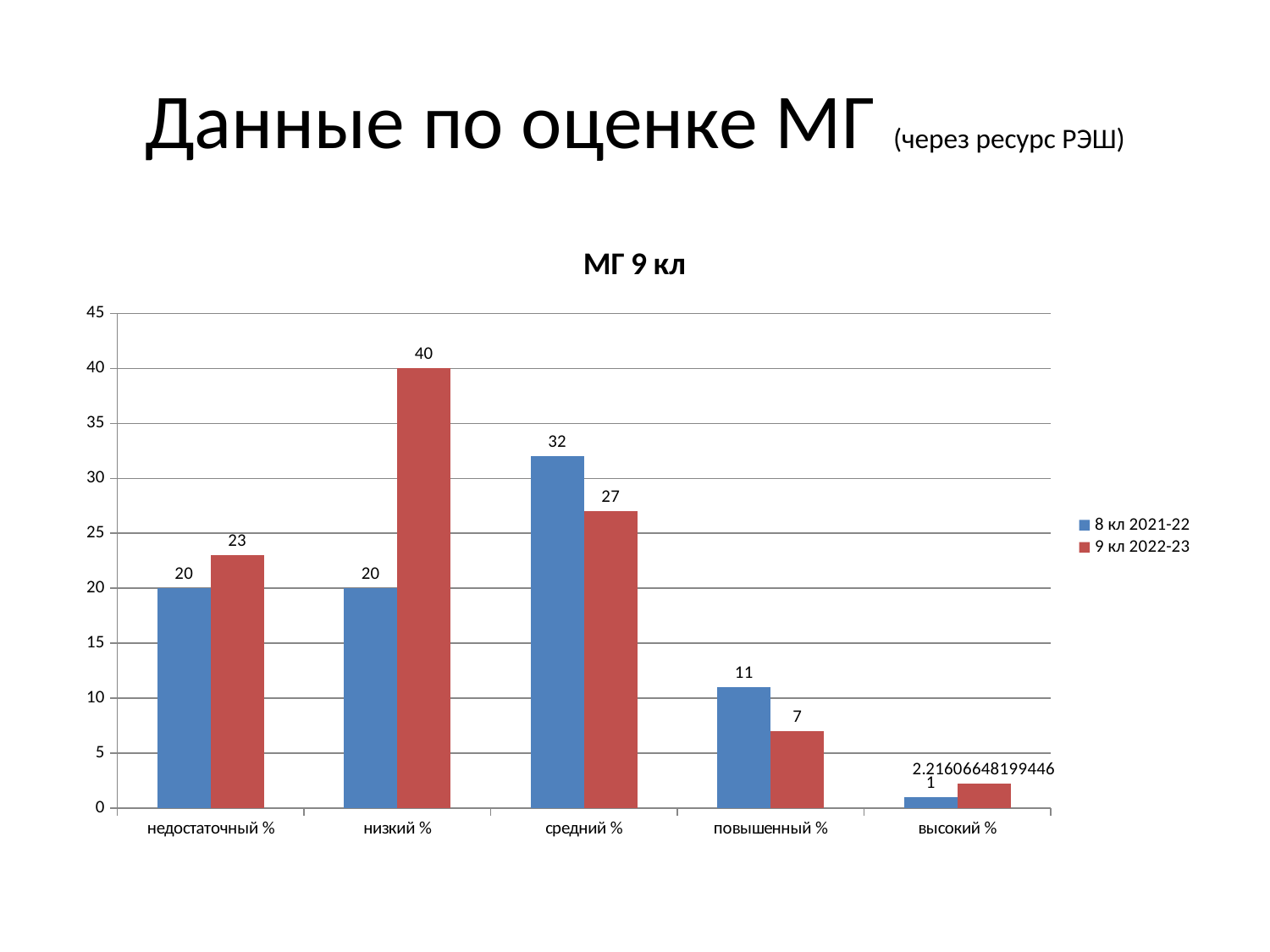
Which category has the highest value in the "9 кл 2022-23" series? низкий % For "средний %", which series has the larger value, "8 кл 2021-22" or "9 кл 2022-23"? 8 кл 2021-22 Which category has the lowest value in the "8 кл 2021-22" series? высокий % What is the value for "высокий %" in the "8 кл 2021-22" series? 1 How many categories are shown on the x axis? 5 How many series does the legend list? 2 What is the title of the chart? МГ 9 кл What is the value for "средний %" in the "8 кл 2021-22" series? 32 What is the value for "повышенный %" in the "9 кл 2022-23" series? 7 What is the difference between the "9 кл 2022-23" and "8 кл 2021-22" values for "низкий %"? 20 What is the value for "низкий %" in the "9 кл 2022-23" series? 40 What type of chart is shown on the slide? bar chart